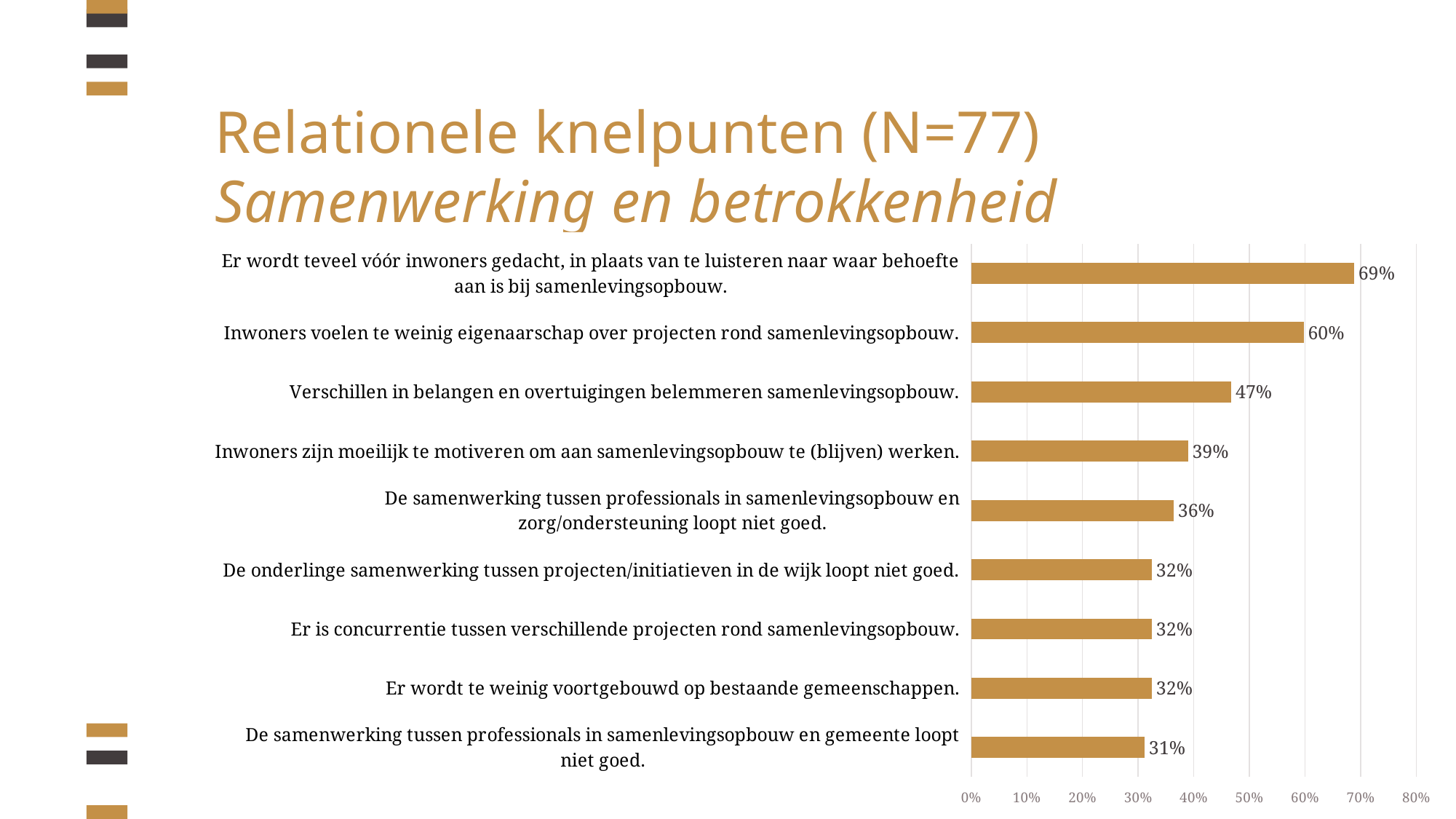
What percentage is shown for 'Inwoners zijn moeilijk te motiveren om aan samenlevingsopbouw te (blijven) werken.'? 39% Which category has the lowest percentage? De samenwerking tussen professionals in samenlevingsopbouw en gemeente loopt niet goed. What kind of chart is shown on the slide? Bar chart What percentage is shown for 'Verschillen in belangen en overtuigingen belemmeren samenlevingsopbouw.'? 47% How many categories (bars) does the chart show? 9 What is the difference in percentage points between the highest bar (69%) and 'Inwoners voelen te weinig eigenaarschap over projecten rond samenlevingsopbouw.' (60%)? 9 percentage points What percentage is shown for 'De samenwerking tussen professionals in samenlevingsopbouw en gemeente loopt niet goed.'? 31% Which category has the highest percentage? Er wordt teveel vóór inwoners gedacht, in plaats van te luisteren naar waar behoefte aan is bij samenlevingsopbouw. What is the maximum value shown on the percentage axis? 80% Which is larger: the value for 'Verschillen in belangen en overtuigingen belemmeren samenlevingsopbouw.' or the value for 'De samenwerking tussen professionals in samenlevingsopbouw en zorg/ondersteuning loopt niet goed.'? Verschillen in belangen en overtuigingen belemmeren samenlevingsopbouw. How many categories share the value 32%? 3 What percentage is shown for 'Inwoners voelen te weinig eigenaarschap over projecten rond samenlevingsopbouw.'? 60%